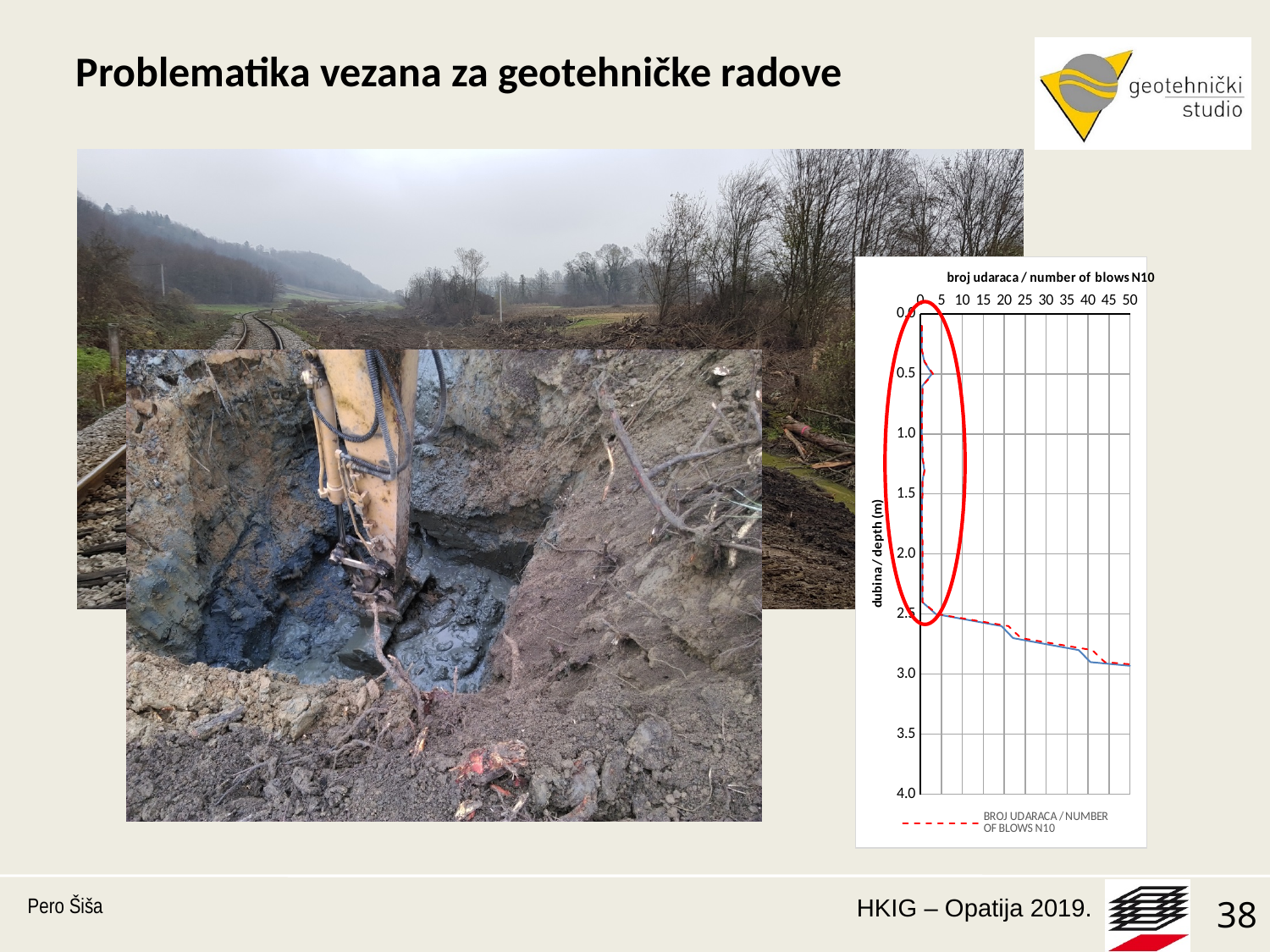
What is the label of the vertical axis of the chart? dubina / depth (m) What is the title of the chart on the right side of the slide? broj udaraca / number of blows N10 What is the deepest depth shown on the vertical axis of the chart? 4.0 Do the number of blows increase or decrease as depth goes from 2.5 m to 3.0 m? increase What is the largest value shown on the horizontal axis of the chart? 50 Is the number of blows at a depth of 2.0 m greater or less than 5? less Is the number of blows at the deepest plotted point (just below 2.9 m) greater or less than 40? greater What kind of chart is shown on the right side of the slide? line chart What is the spacing between consecutive tick labels on the horizontal axis of the chart? 5 Which depth has the larger number of blows, 1.5 m or 2.9 m? 2.9 m How many entries does the chart's legend list? 1 Is the number of blows at a depth of 1.0 m greater or less than 10? less